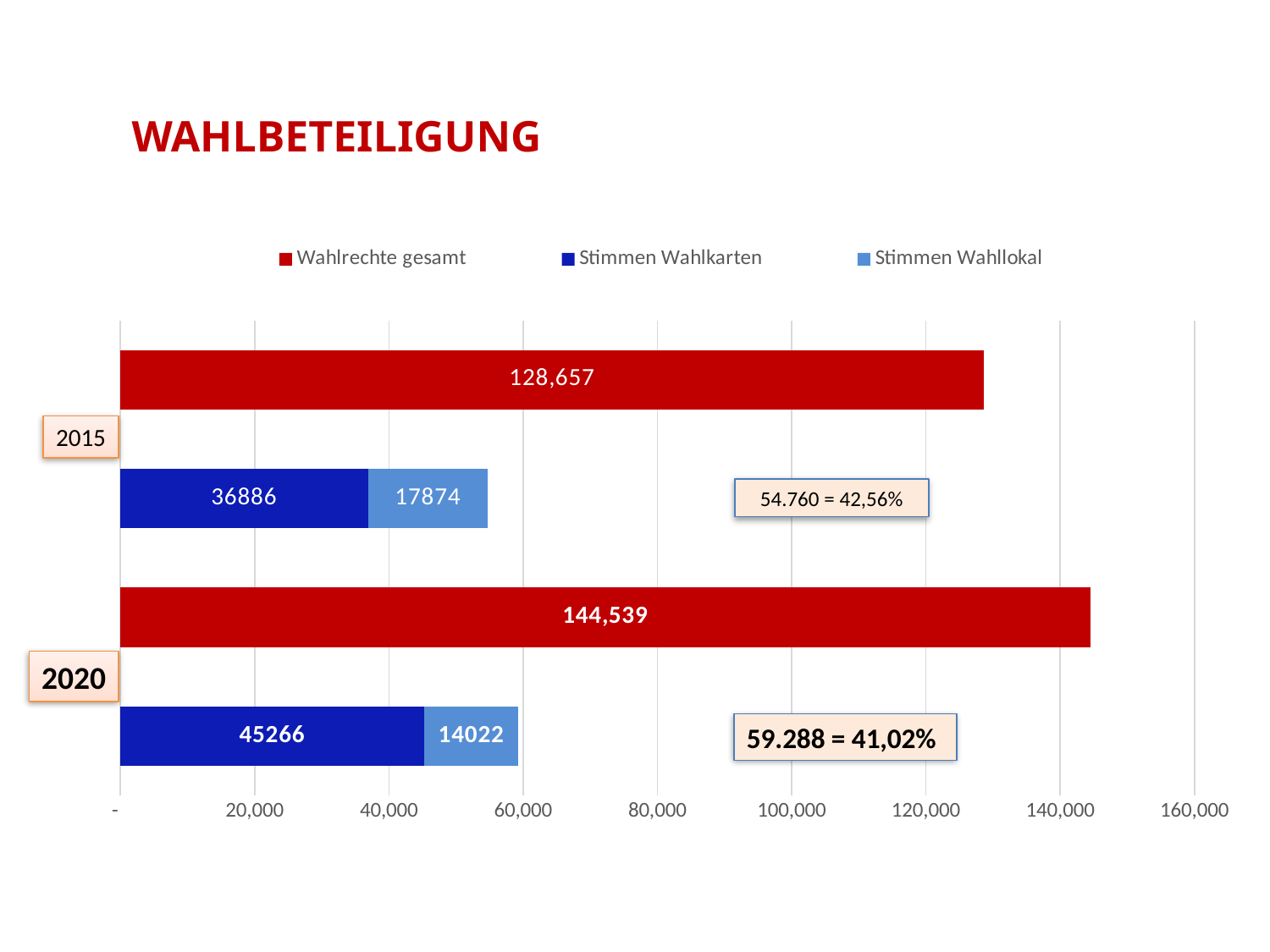
Which year has the higher value for Wahlrechte gesamt, 2015 or 2020? 2020 What kind of chart is shown on the slide? Bar chart What is the value of Wahlrechte gesamt for 2015? 128,657 What is the value of Stimmen Wahlkarten for 2020? 45266 What is the value of Stimmen Wahllokal for 2015? 17874 What is the difference between Stimmen Wahlkarten in 2020 and in 2015? 8380 How many series does the legend list? 3 How many years (categories) are shown on the chart? 2 What is the value of Wahlrechte gesamt for 2020? 144,539 What is the total of the stacked bar for Stimmen Wahlkarten and Stimmen Wahllokal in 2015? 54760 What is the difference between Wahlrechte gesamt in 2020 and in 2015? 15,882 Which year has the higher value for Stimmen Wahllokal, 2015 or 2020? 2015